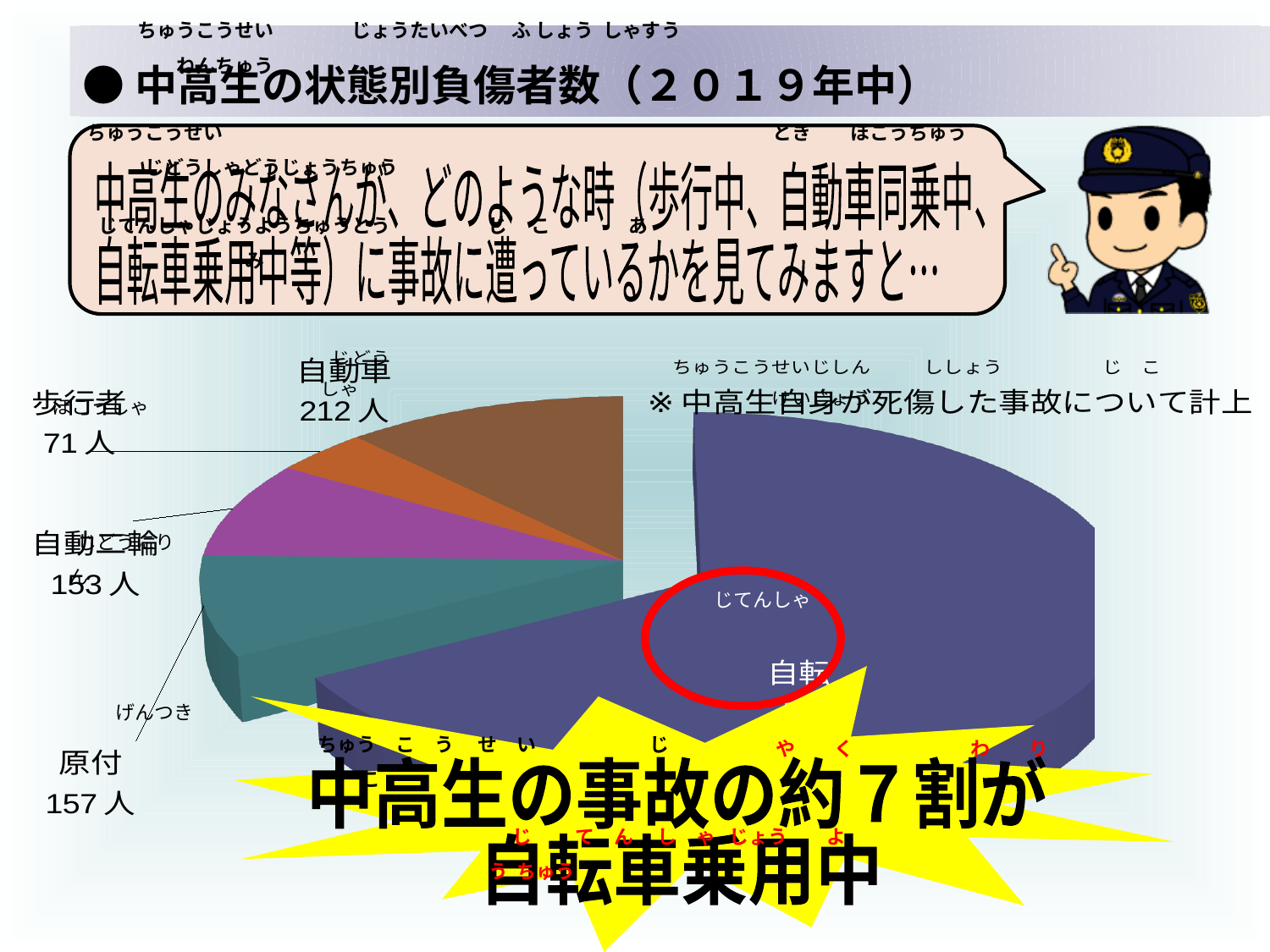
What is the value shown for 原付 (moped)? 157人 What is the difference between the values for 自動車 and 歩行者? 141人 Which is larger, the value for 原付 or the value for 歩行者? 原付 How many categories (slices) does the pie chart have? 5 According to the highlighted text on the slide, roughly what share of middle and high school student accidents occur while riding a bicycle? 約7割 Which category has the largest slice of the pie? 自転車 Which is larger, the value for 自動車 or the value for 原付? 自動車 How many injured students are shown for 歩行者 (pedestrians)? 71人 What is the difference between the values for 自動車 and 原付? 55人 What kind of chart is shown on the slide? Pie chart Which category has the smallest slice of the pie? 歩行者 What is the value shown for 自動車 (automobile)? 212人